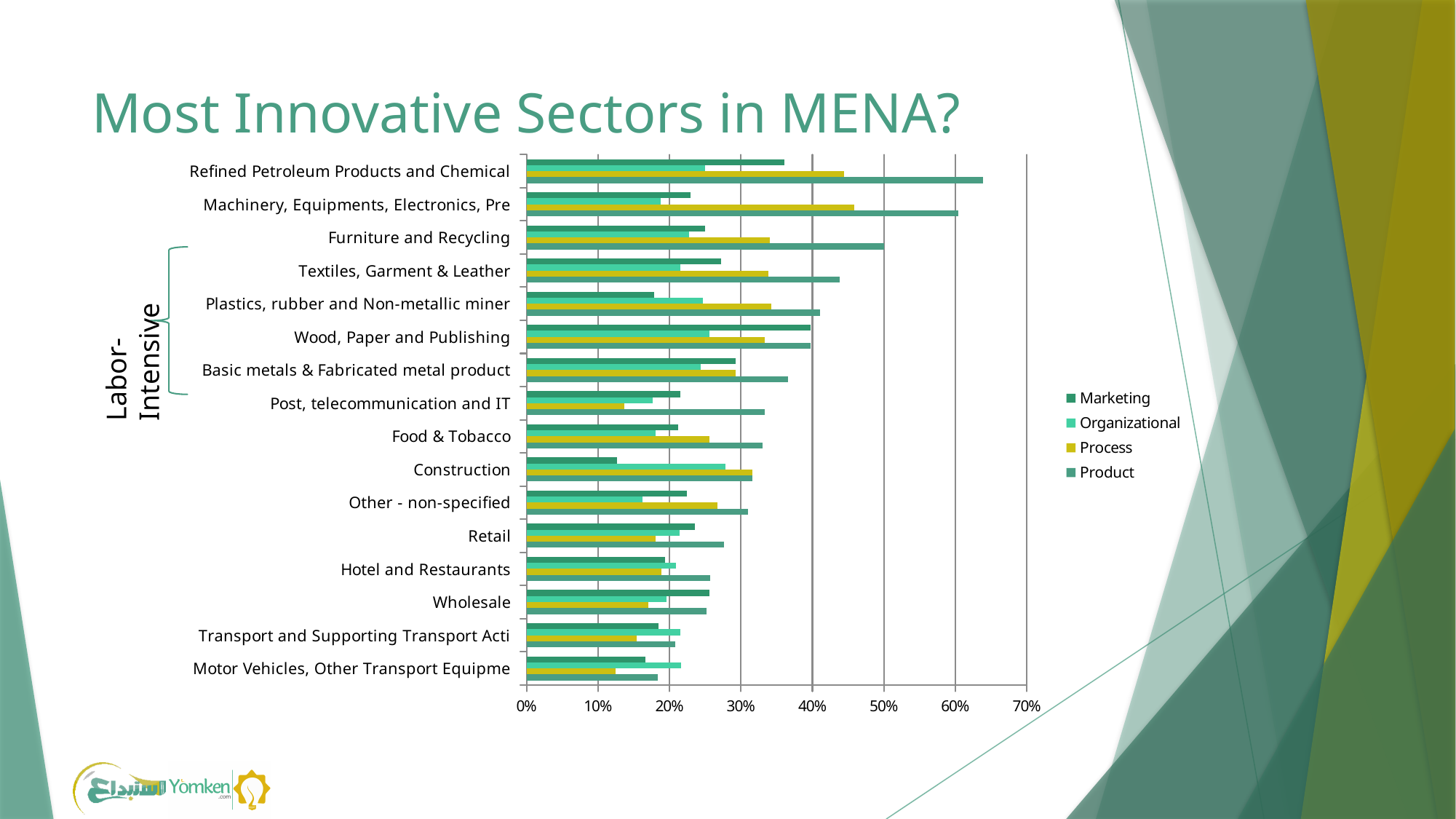
Which sector has the lowest Marketing value? Construction How many series does the legend list? 4 Is the Marketing value for Construction greater or less than 20%? less What kind of chart is shown on the slide? Bar chart How many sectors (categories) are plotted on the chart? 16 Is the Product value for Motor Vehicles, Other Transport Equipme greater or less than 20%? less For Construction, which is larger: the Marketing value or the Product value? Product Is the Process value for Refined Petroleum Products and Chemical greater or less than 40%? greater What is the title of the slide containing the chart? Most Innovative Sectors in MENA? Which sector has the highest Product value? Refined Petroleum Products and Chemical Which series are listed in the chart legend? Marketing, Organizational, Process, Product